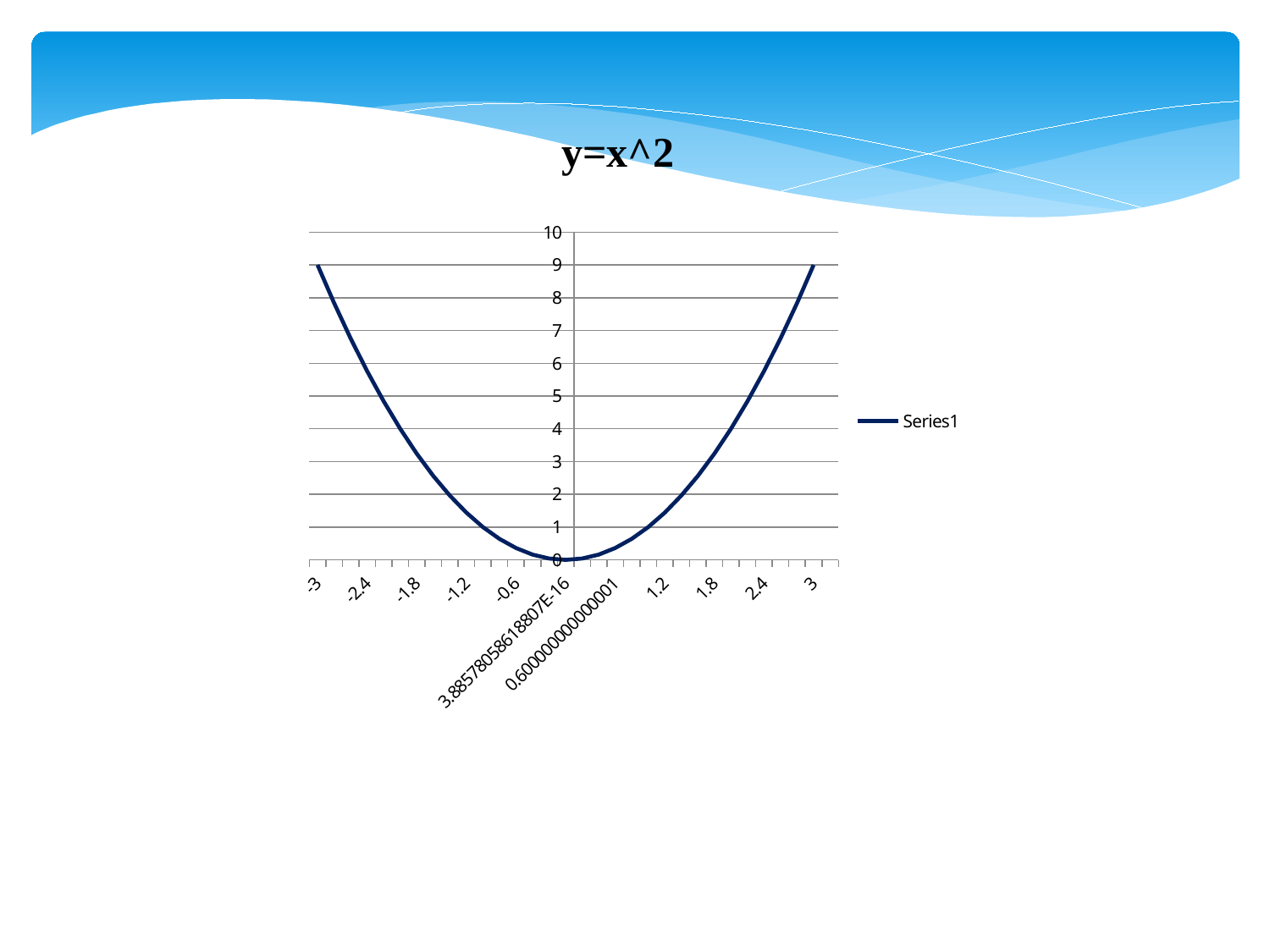
Is the value for x = -0.6 greater or less than 1? less What is the value of Series1 at x = 3? 9 What is the name of the series shown in the legend? Series1 Does the curve rise or fall as x goes from -3 to 0? fall What is the value of Series1 at x = -3? 9 What is the title of the chart? y=x^2 What type of chart is shown on the slide? line chart What is the highest value reached by the curve? 9 How many labels are shown on the x axis? 11 Is the value for x = 2.4 greater or less than 5? greater How many series does the legend list? 1 What is the lowest value reached by the curve? 0